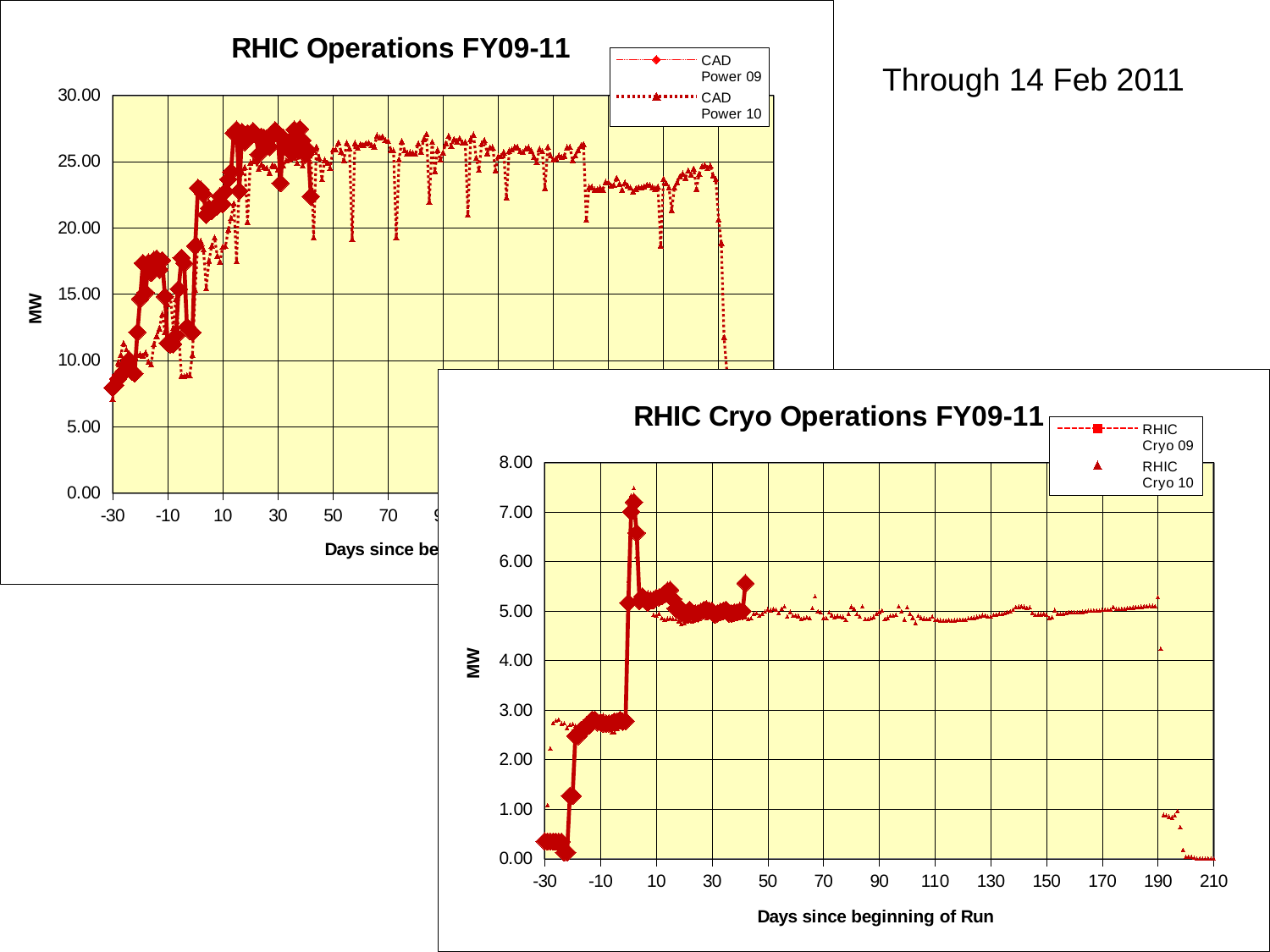
How many series does the legend of the 'RHIC Operations FY09-11' chart list? 2 In the 'RHIC Operations FY09-11' chart, is the value for CAD Power 09 at day -30 greater or less than 10.00? less How many series does the legend of the 'RHIC Cryo Operations FY09-11' chart list? 2 In the 'RHIC Cryo Operations FY09-11' chart, is the value for RHIC Cryo 09 at day -30 greater or less than 1.00? less In the 'RHIC Operations FY09-11' chart, is the value for CAD Power 10 at day 150 greater or less than 25.00? less What is the y-axis label on the 'RHIC Cryo Operations FY09-11' chart? MW What kind of chart is the 'RHIC Operations FY09-11' chart? line chart In the 'RHIC Cryo Operations FY09-11' chart, what are the two series named in the legend? RHIC Cryo 09 and RHIC Cryo 10 What kind of chart is the 'RHIC Cryo Operations FY09-11' chart? line chart In the 'RHIC Operations FY09-11' chart, does the CAD Power 09 series rise or fall between day -30 and day 30? rise In the 'RHIC Cryo Operations FY09-11' chart, does the RHIC Cryo 09 series rise or fall between day -30 and day 0? rise